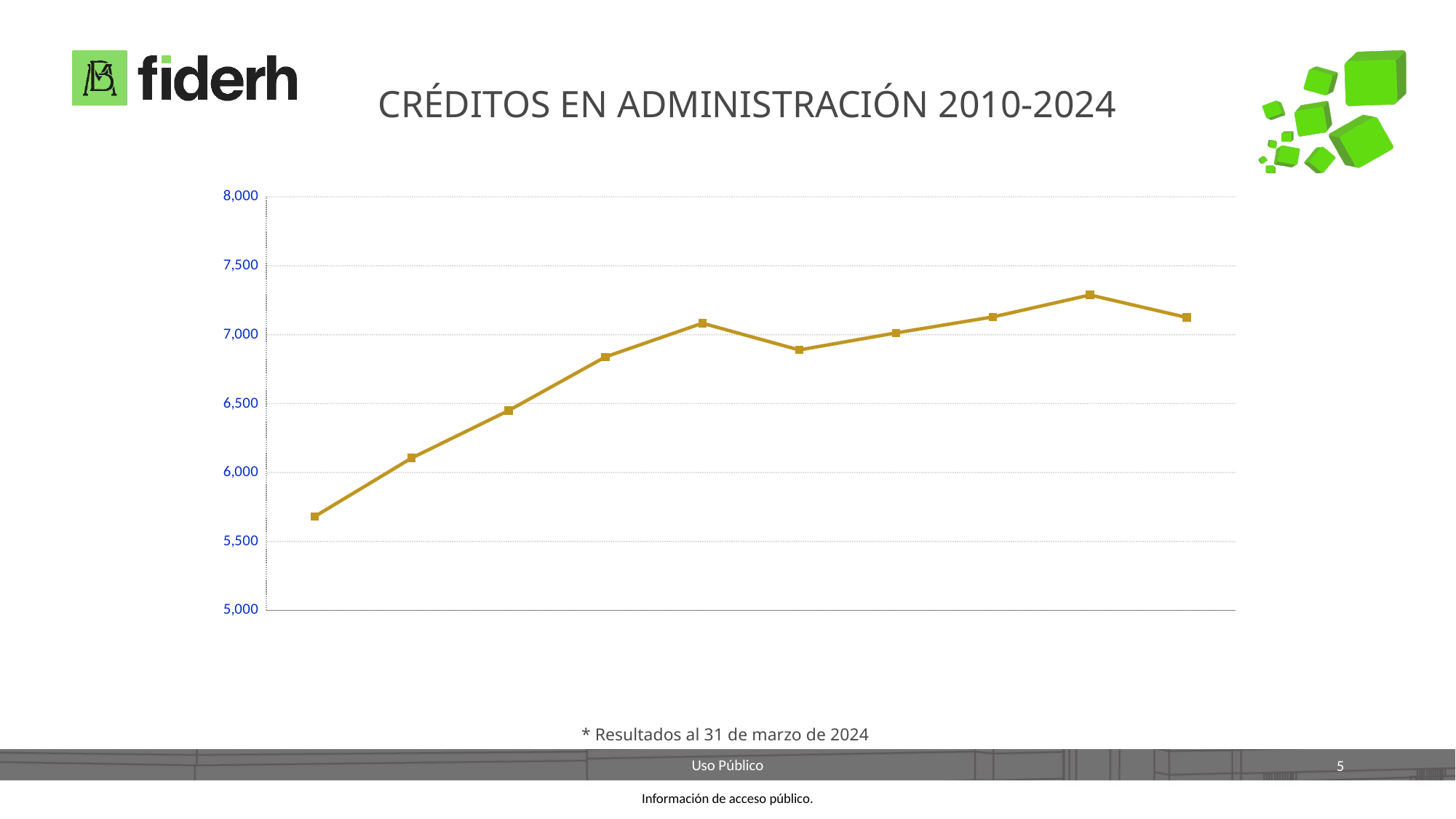
What is the title of the chart on the slide? CRÉDITOS EN ADMINISTRACIÓN 2010-2024 Is the value of the sixth point from the left greater or less than 7,000? less Is the value of the last (rightmost) point greater or less than 7,000? greater What kind of chart is shown on the slide? line chart Which point on the line has the lowest value? the first (leftmost) point Is the value of the first (leftmost) point greater or less than 6,000? less How many data points are plotted on the line? 10 Which point on the line has the highest value? the ninth point (second from the right) Overall, do the values rise or fall from left to right along the x axis? rise Which is larger, the value of the first point or the value of the last point? the last point